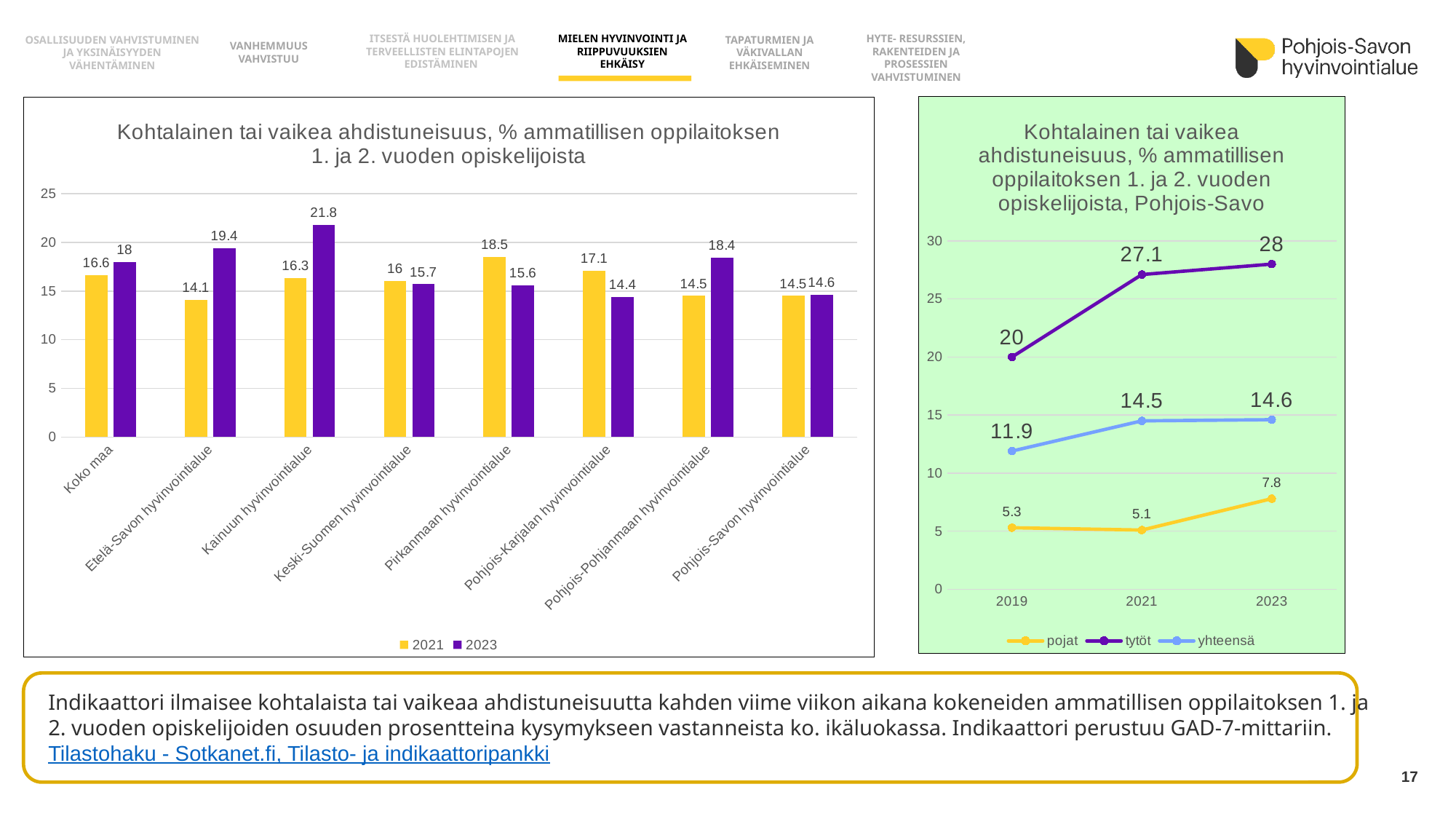
In the right line chart, what is the value for tytöt in 2021? 27.1 How many regions are shown on the x axis of the left bar chart? 8 In the left bar chart, is the 2021 value for Pirkanmaan hyvinvointialue larger or the 2023 value? 2021 In the left bar chart, which region has the lowest 2021 value? Etelä-Savon hyvinvointialue In the left bar chart, what is the 2023 value for Kainuun hyvinvointialue? 21.8 What kind of chart is the chart on the right of the slide? Line chart How many series does the legend of the left chart list? 2 In the left bar chart, what is the difference between the 2023 and 2021 values for Etelä-Savon hyvinvointialue? 5.3 In the left bar chart, which region has the highest 2023 value? Kainuun hyvinvointialue In the right line chart, what is the difference between the tytöt and pojat values in 2023? 20.2 In the left bar chart, what is the 2021 value for Koko maa? 16.6 In the right line chart, does the value for pojat rise or fall from 2021 to 2023? Rise